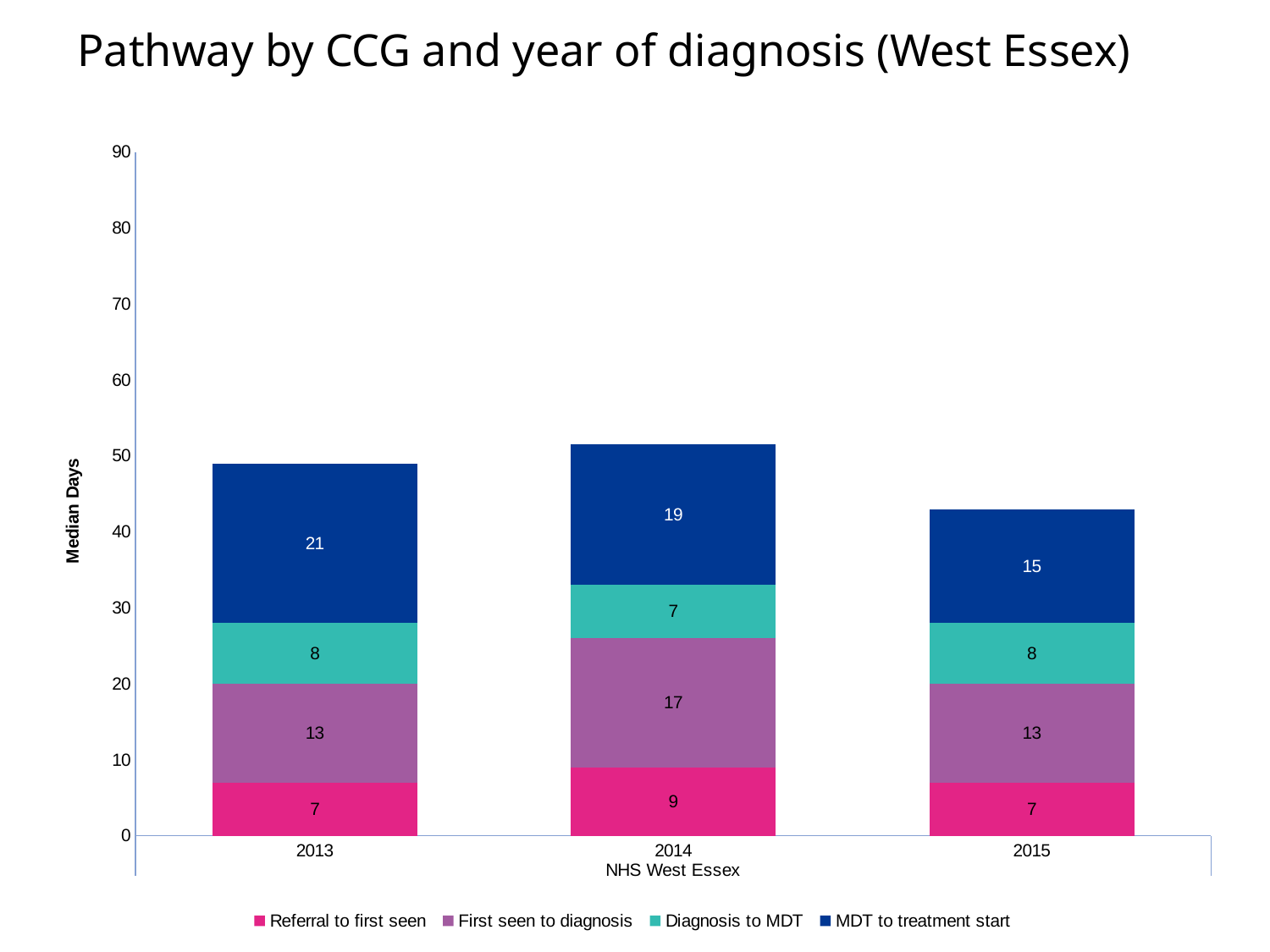
What is the difference between the MDT to treatment start values for 2013 and 2015? 6 What is the value for MDT to treatment start in 2014? 19 Which is larger: First seen to diagnosis in 2014 or in 2013? 2014 What is the value for Referral to first seen in 2014? 9 What is the total of the stacked bar for 2014? 52 What is the value for First seen to diagnosis in 2015? 13 How many series does the legend list? 4 What is the value for Diagnosis to MDT in 2013? 8 Which year has the highest value for MDT to treatment start? 2013 What kind of chart is shown on the slide? Stacked bar chart What is the total of the stacked bar for 2015? 43 Which year has the lowest value for Diagnosis to MDT? 2014